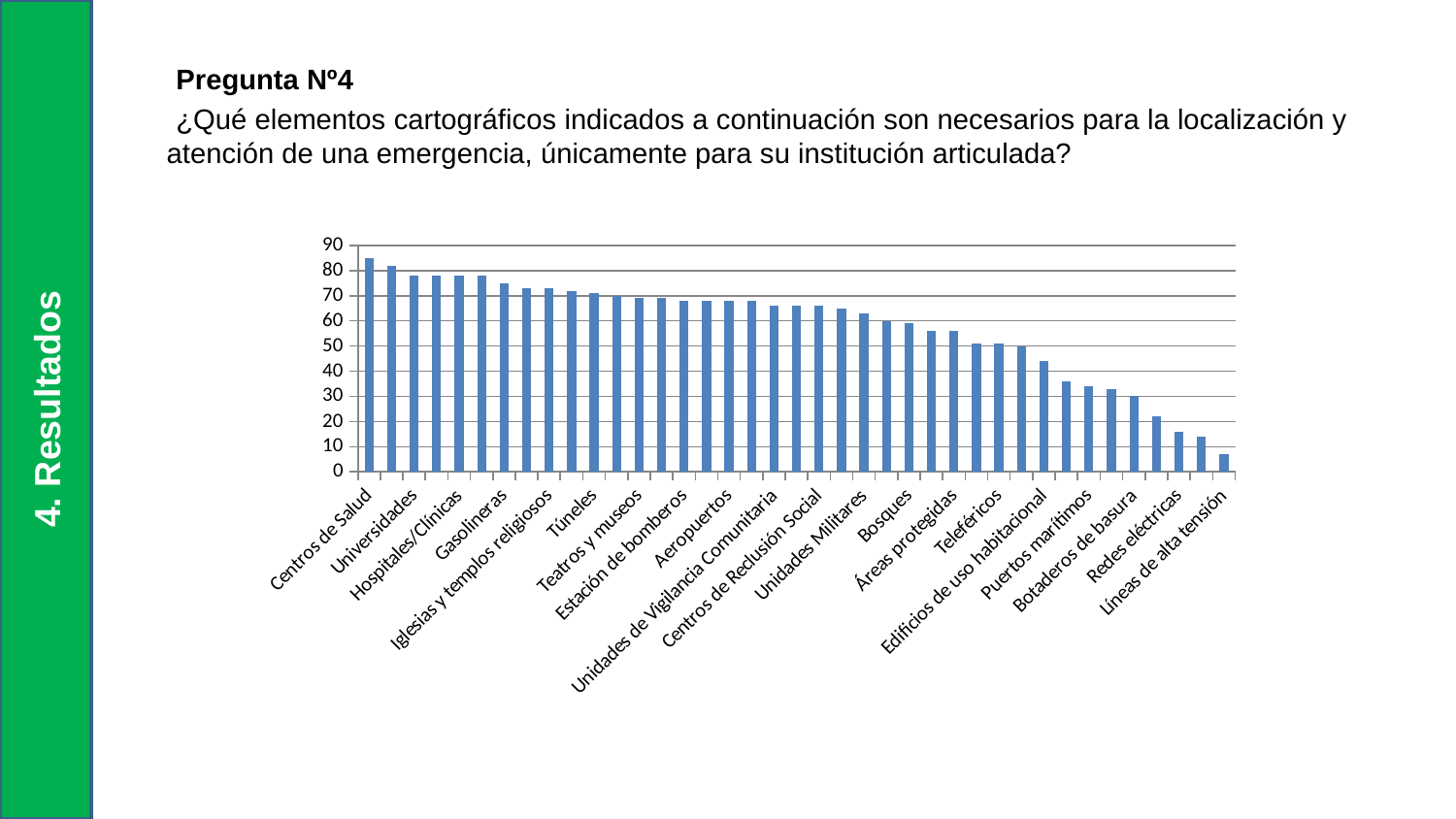
What kind of chart is shown on the slide? bar chart Which question number does the chart on the slide correspond to? Pregunta Nº4 Is the value for Líneas de alta tensión greater or less than 20? less Is the value for Líneas de alta tensión greater or less than 10? less Which category has the highest value in the chart? Centros de Salud Which is larger, the value for Centros de Salud or the value for Líneas de alta tensión? Centros de Salud Is the value for Centros de Salud greater or less than 80? greater Do the values rise or fall moving from left to right along the x axis? fall Which category has the lowest value in the chart? Líneas de alta tensión What is the highest tick value shown on the vertical axis? 90